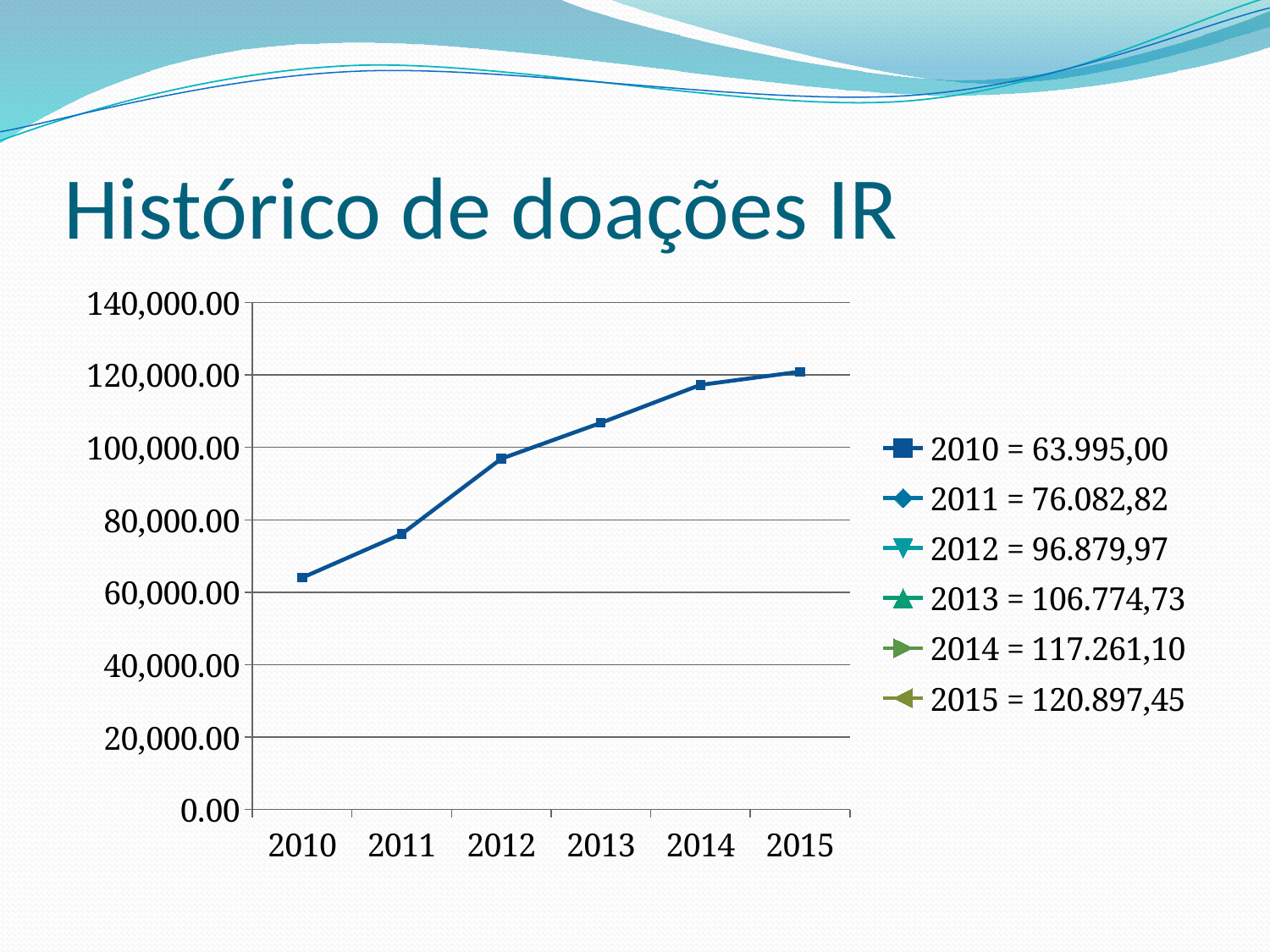
Is the value for 2014 greater or less than 100,000.00? greater Which is larger, the value for 2013 or the value for 2012? 2013 Which year has the lowest value on the chart? 2010 What is the difference between the values for 2015 and 2010? 56.902,45 According to the legend, what is the value for 2012? 96.879,97 According to the legend, what is the value for 2010? 63.995,00 What is the title of the slide containing the chart? Histórico de doações IR What type of chart is shown on the slide? line chart Which year has the highest value on the chart? 2015 How many data points are plotted on the line? 6 According to the legend, what is the value for 2015? 120.897,45 Do the values rise or fall from 2010 to 2015? rise